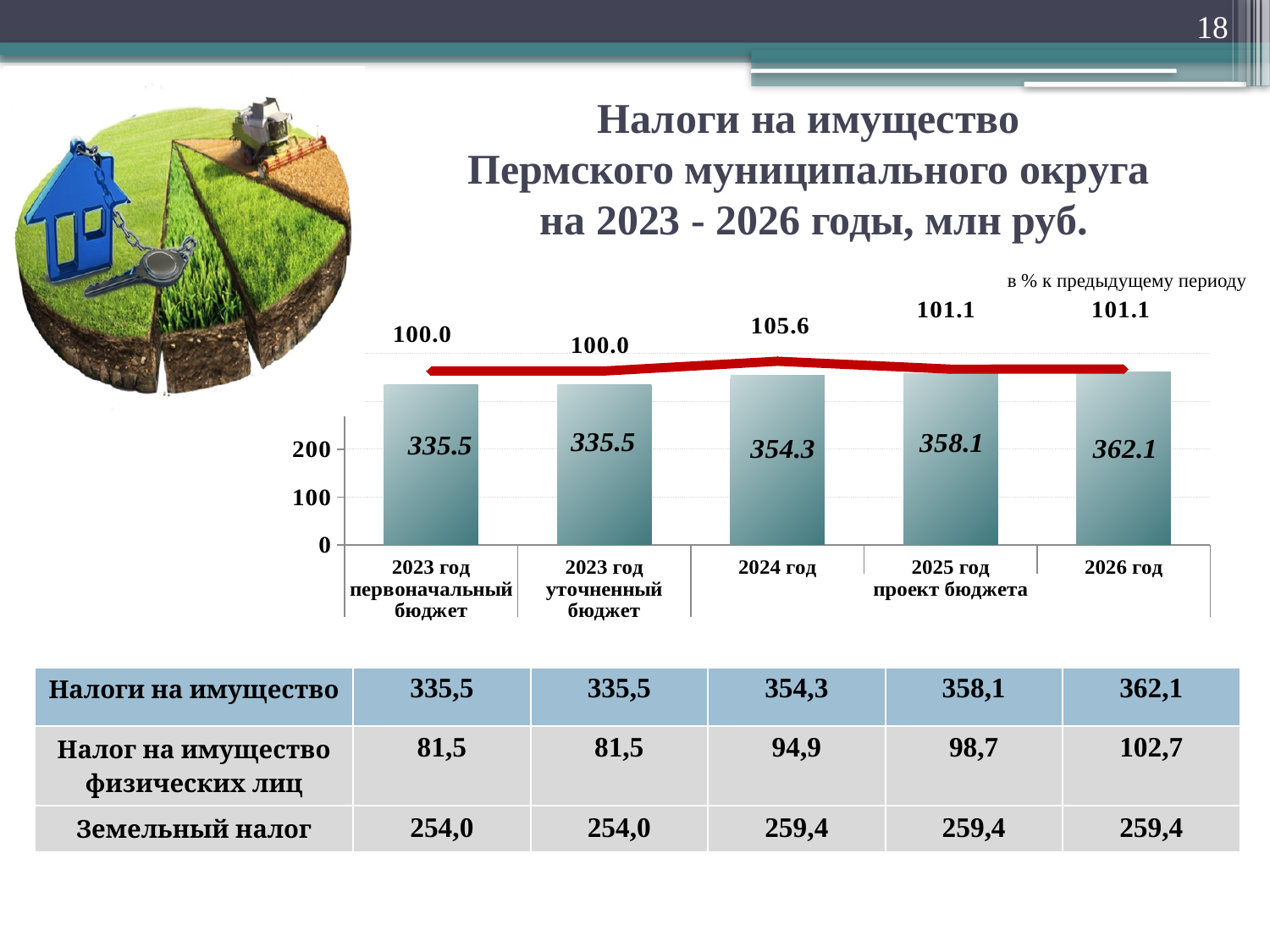
What is the value of the bar for 2024 год? 354.3 Which category has the highest bar value? 2026 год What is the line value (в % к предыдущему периоду) shown above the 2025 год bar? 101.1 What is the value of the bar for 2023 год уточненный бюджет? 335.5 What is the line value (в % к предыдущему периоду) shown above the 2024 год bar? 105.6 Do the bar values rise or fall from 2023 год уточненный бюджет to 2026 год? rise What kind of chart is shown on the slide? bar chart with a line How many bars are shown in the chart? 5 What is the value of the bar for 2026 год? 362.1 Which is larger, the bar value for 2025 год or for 2024 год? 2025 год What is the difference between the bar values for 2026 год and 2024 год? 7.8 What is the difference between the bar values for 2025 год and 2023 год уточненный бюджет? 22.6